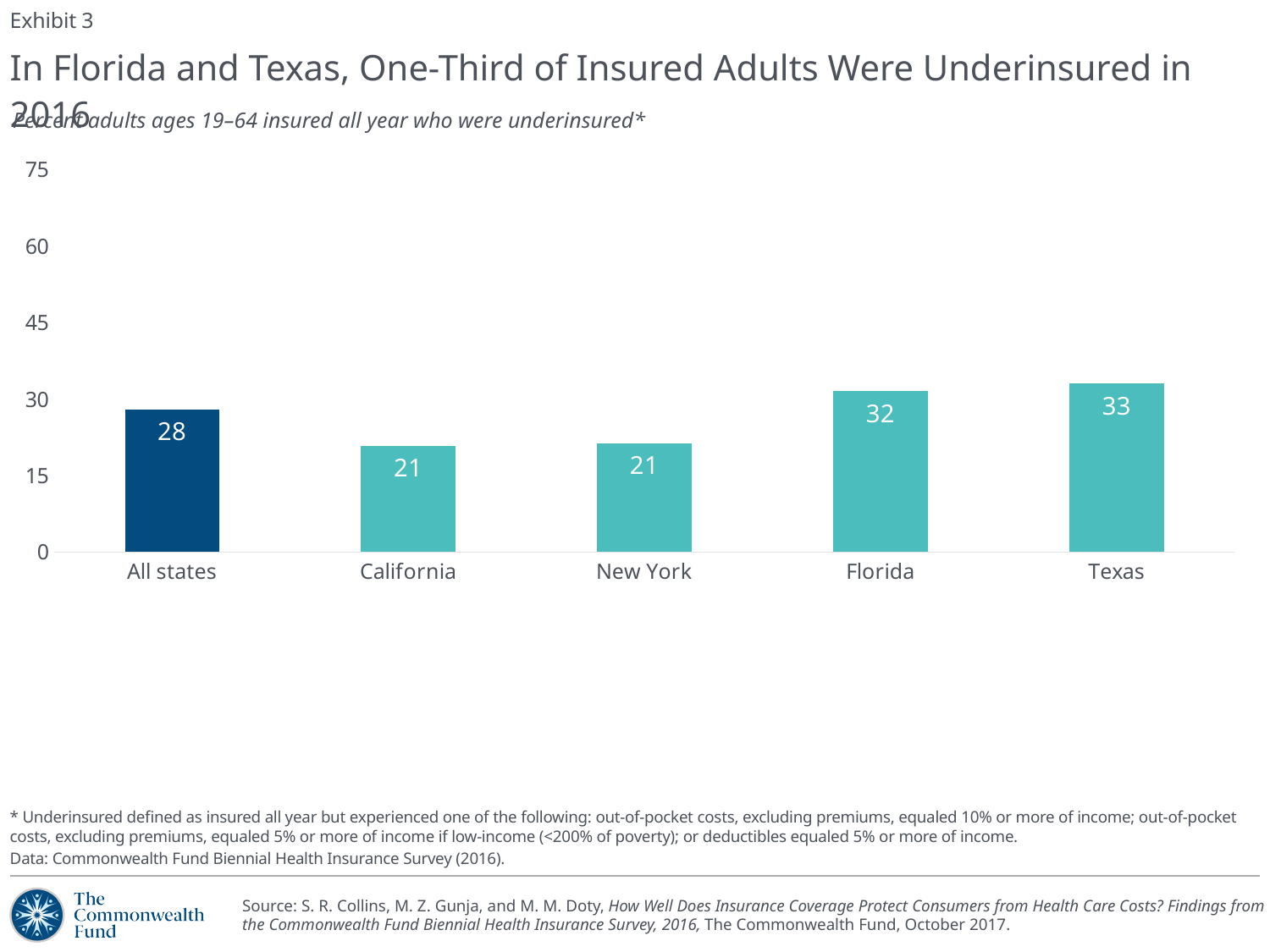
What is the difference between the values for Texas and California? 12 Is the value for Texas greater or less than 30? greater Which category has the highest value? Texas Which is larger, the value for Florida or the value for New York? Florida What is the difference between the values for Florida and All states? 4 What is the value for Florida? 32 What is the value for All states? 28 What kind of chart is shown on the slide? bar chart Which bar is shown in a darker blue colour than the others? All states What is the value for California? 21 Is the value for New York greater or less than 30? less How many categories are shown on the x axis? 5